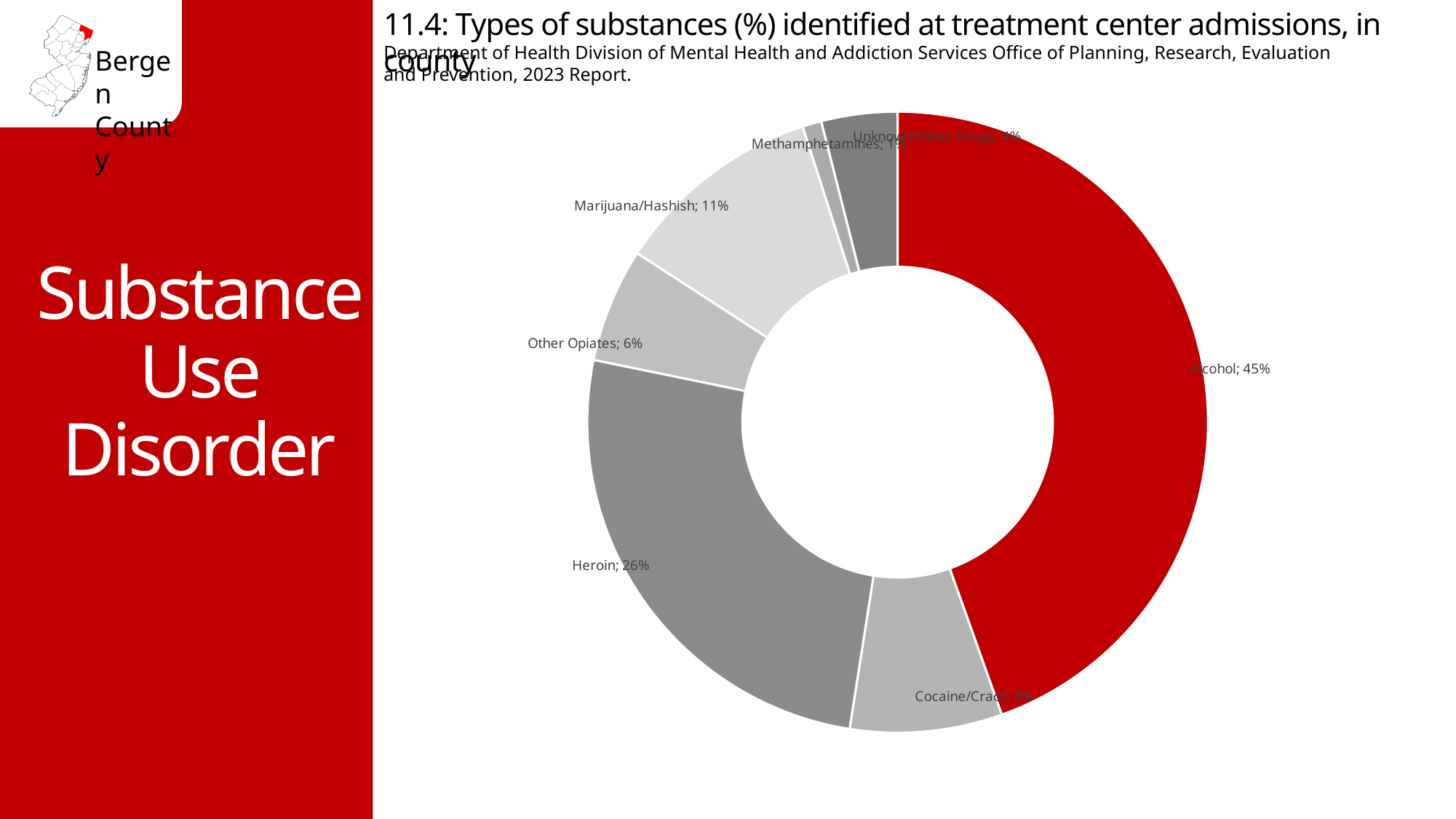
Which substance has the largest share of admissions? Alcohol What percentage is shown for Marijuana/Hashish? 11% What percentage is shown for Heroin? 26% What percentage is shown for Cocaine/Crack? 8% What is the title of the chart? 11.4: Types of substances (%) identified at treatment center admissions, in county What is the difference in percentage points between Alcohol and Heroin? 19% What is the difference in percentage points between Marijuana/Hashish and Other Opiates? 5% What kind of chart is shown on the slide? Doughnut (pie) chart Which has a larger share, Heroin or Marijuana/Hashish? Heroin What percentage of treatment center admissions identified Alcohol? 45% What percentage is shown for Other Opiates? 6% What percentage is shown for Unknown/Other Drugs? 4%